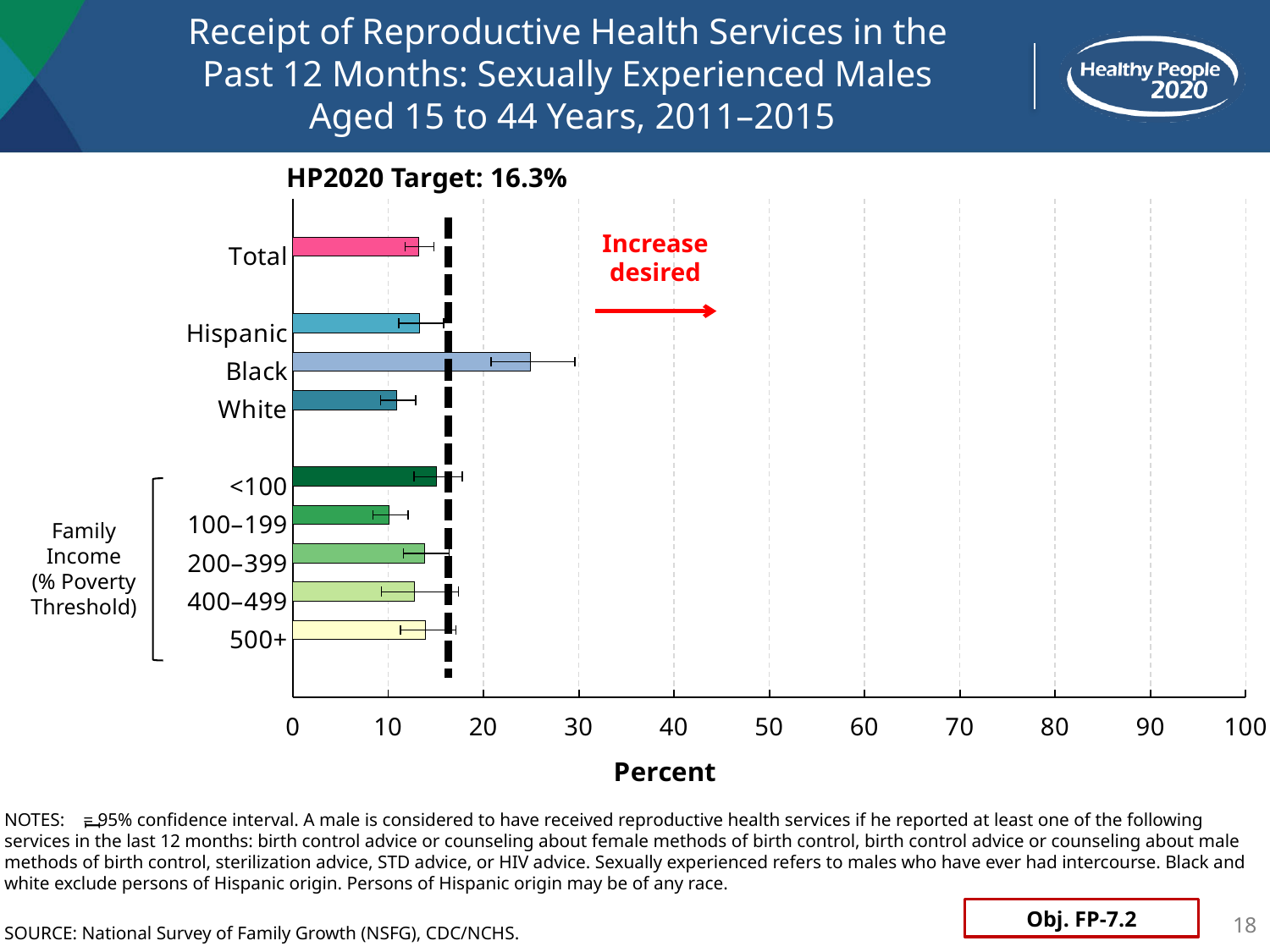
What is the HP2020 Target shown on the chart? 16.3% Is the value for 100–199 greater or less than 20? less Is the value for Total greater or less than 20? less Which is larger, the value for Black or the value for Total? Black How many Family Income categories are plotted in the chart? 5 Which category has the highest percentage in the chart? Black How many bars are plotted in the chart? 9 Is the value for White greater or less than 20? less What kind of chart is shown on the slide? bar chart What is the label of the x axis? Percent Which is larger, the value for Black or the value for White? Black